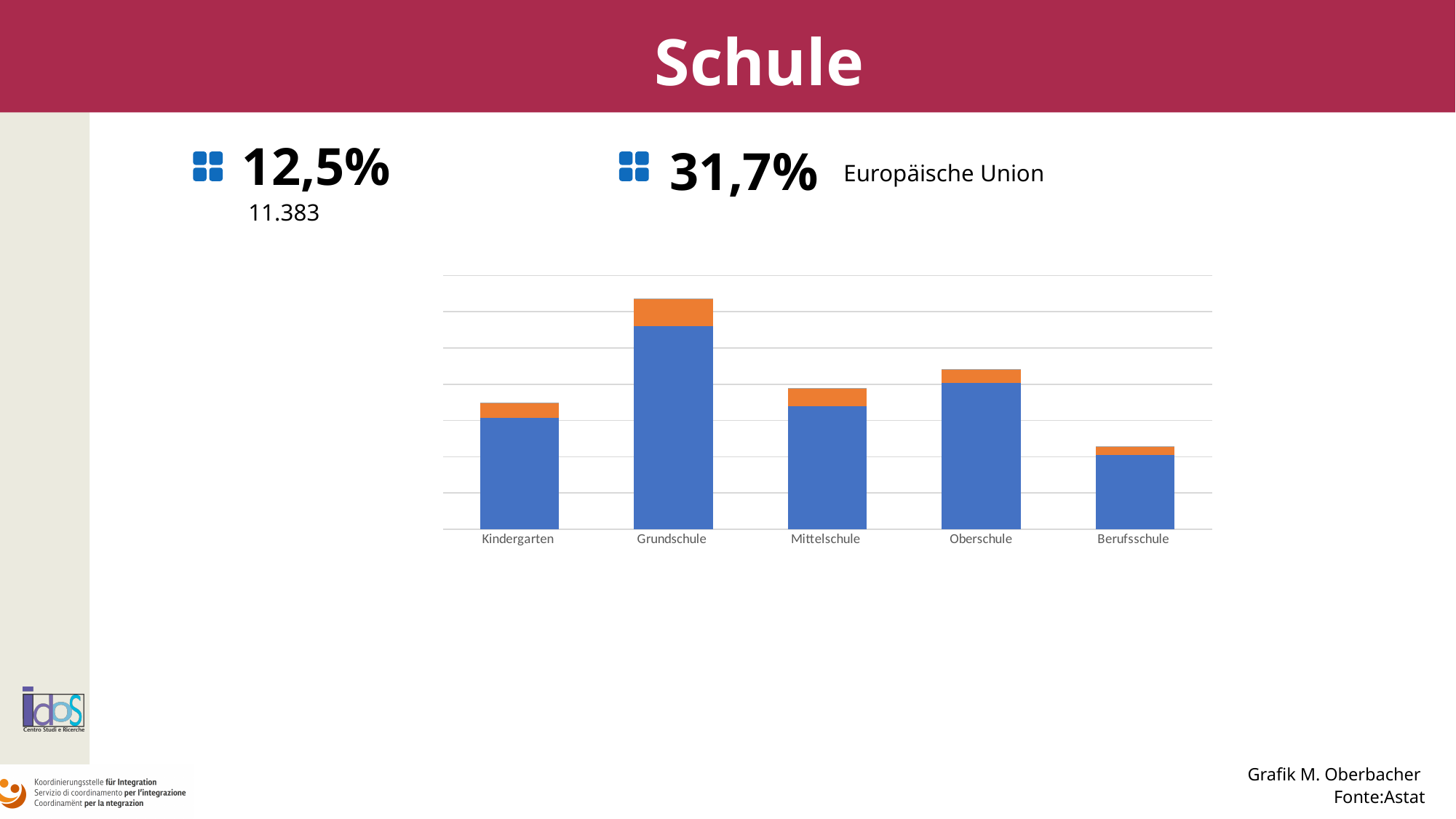
Which bar is taller, Oberschule or Mittelschule? Oberschule How many categories are shown on the x axis of the chart? 5 Which bar is taller, Kindergarten or Berufsschule? Kindergarten Which bar is taller, Grundschule or Oberschule? Grundschule Which category has the shortest bar in the chart? Berufsschule What is the label of the first category on the x axis? Kindergarten What kind of chart is shown on the slide? bar chart Which category is the second tallest bar in the chart? Oberschule What colour is the lower, larger segment of each stacked bar? blue Which category has the tallest bar in the chart? Grundschule